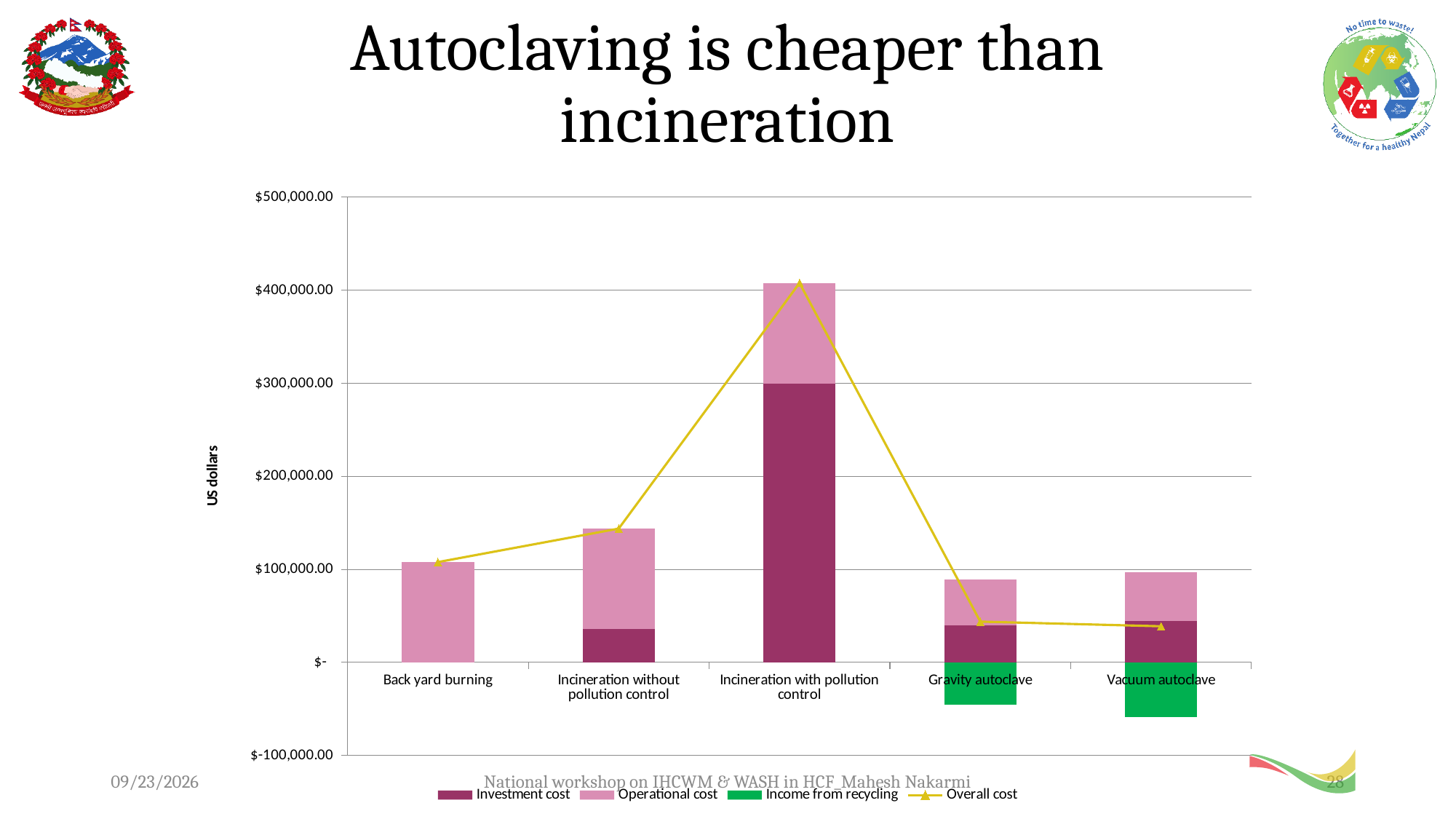
Is the overall cost for Gravity autoclave greater or less than $100,000.00? less What kind of chart is shown on the slide? A stacked bar chart with a line series How many series does the legend list? 4 Which treatment option has the highest overall cost? Incineration with pollution control Is the investment cost for Incineration without pollution control greater or less than $100,000.00? less What is the label on the vertical axis? US dollars Which treatment option has the highest investment cost? Incineration with pollution control Is the overall cost for Incineration with pollution control greater or less than $400,000.00? greater Which has the larger overall cost, Back yard burning or Incineration without pollution control? Incineration without pollution control Which treatment options show income from recycling? Gravity autoclave and Vacuum autoclave How many treatment options (categories) are shown on the x axis? 5